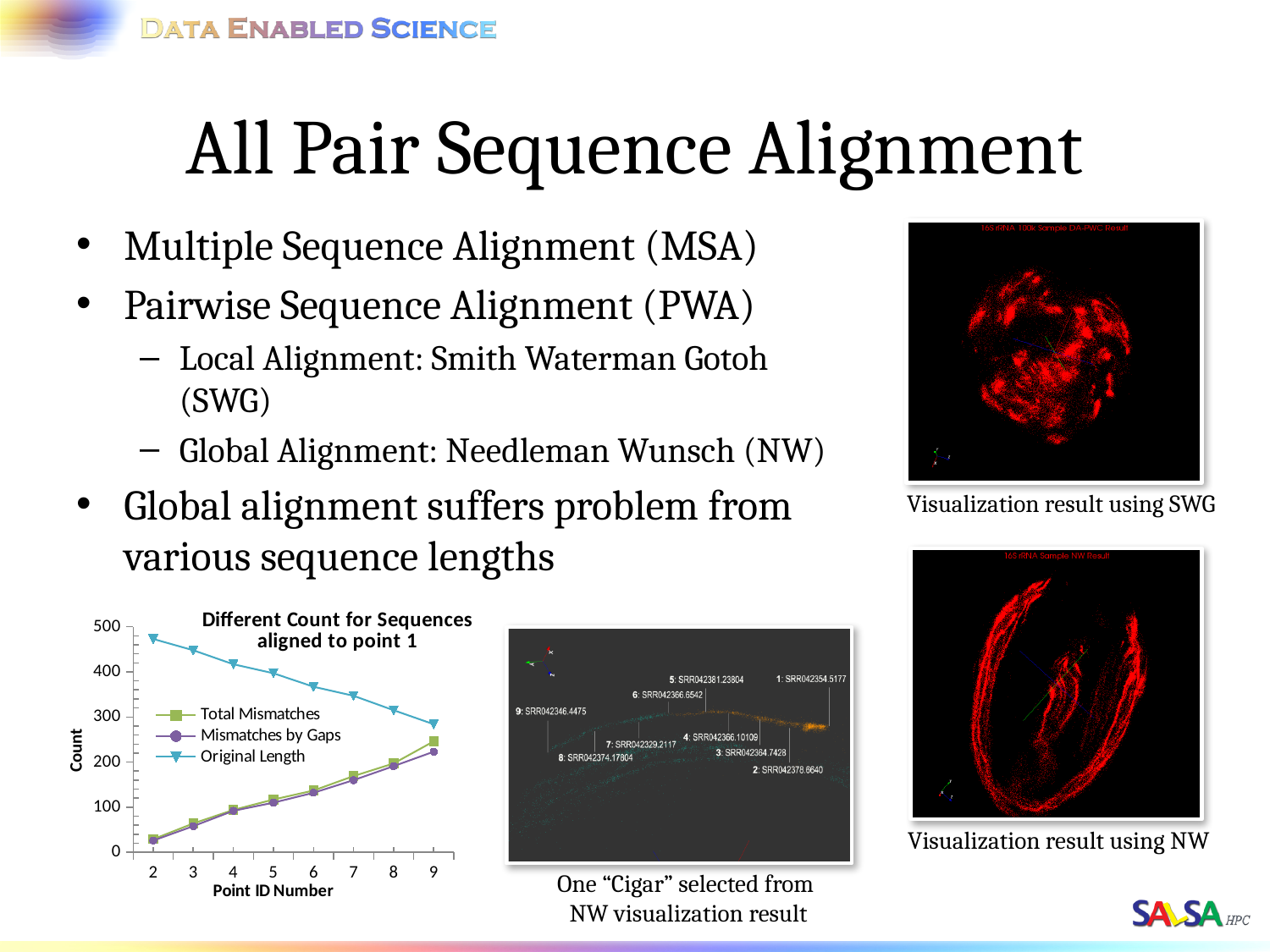
How many series does the legend of the "Different Count for Sequences aligned to point 1" chart list? 3 Is the Total Mismatches value at Point ID Number 2 greater or less than 100? less How many Point ID Numbers are plotted along the x axis of the chart? 8 Does the Total Mismatches series rise or fall as the Point ID Number increases from 2 to 9? rise At which Point ID Number is the Original Length highest? 2 Does the Original Length series rise or fall as the Point ID Number increases from 2 to 9? fall Is the Original Length value at Point ID Number 9 greater or less than 300? less Is the Original Length value at Point ID Number 2 greater or less than 400? greater At Point ID Number 5, which is larger: Original Length or Total Mismatches? Original Length What is the title of the y axis of the chart? Count At which Point ID Number is Total Mismatches lowest? 2 What kind of chart is "Different Count for Sequences aligned to point 1"? line chart